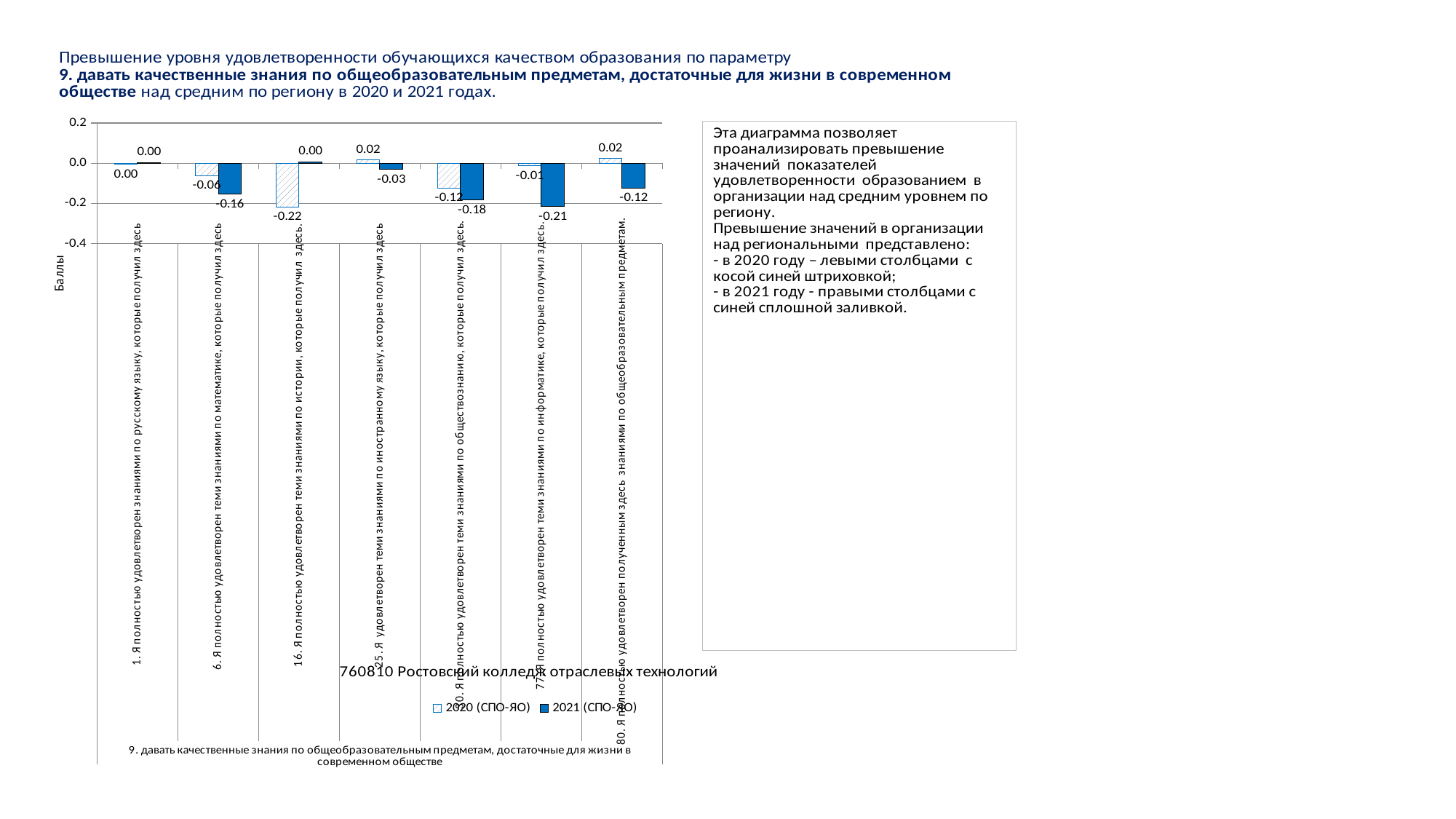
What is the 2020 (СПО-ЯО) value for the category about knowledge of social studies (обществознанию)? -0.12 What is the 2021 (СПО-ЯО) value for the category about knowledge of informatics (информатике)? -0.21 Which category has the lowest 2020 (СПО-ЯО) value? 16. Я полностью удовлетворен теми знаниями по истории, которые получил здесь What is the 2021 (СПО-ЯО) value for the category about knowledge of mathematics (математике)? -0.16 How many categories are shown on the x axis of the chart? 7 What is the label of the vertical axis? Баллы What is the difference between the 2020 and 2021 values for the mathematics (математике) category? 0.10 What is the 2020 (СПО-ЯО) value for the category about knowledge of history (истории)? -0.22 For 2021 (СПО-ЯО), which is larger: the value for social studies (обществознанию) or the value for general education subjects (общеобразовательным предметам)? общеобразовательным предметам (-0.12) What kind of chart is shown on the slide? Bar chart Which category has the lowest 2021 (СПО-ЯО) value? 77. Я полностью удовлетворен теми знаниями по информатике, которые получил здесь How many series does the legend list? 2